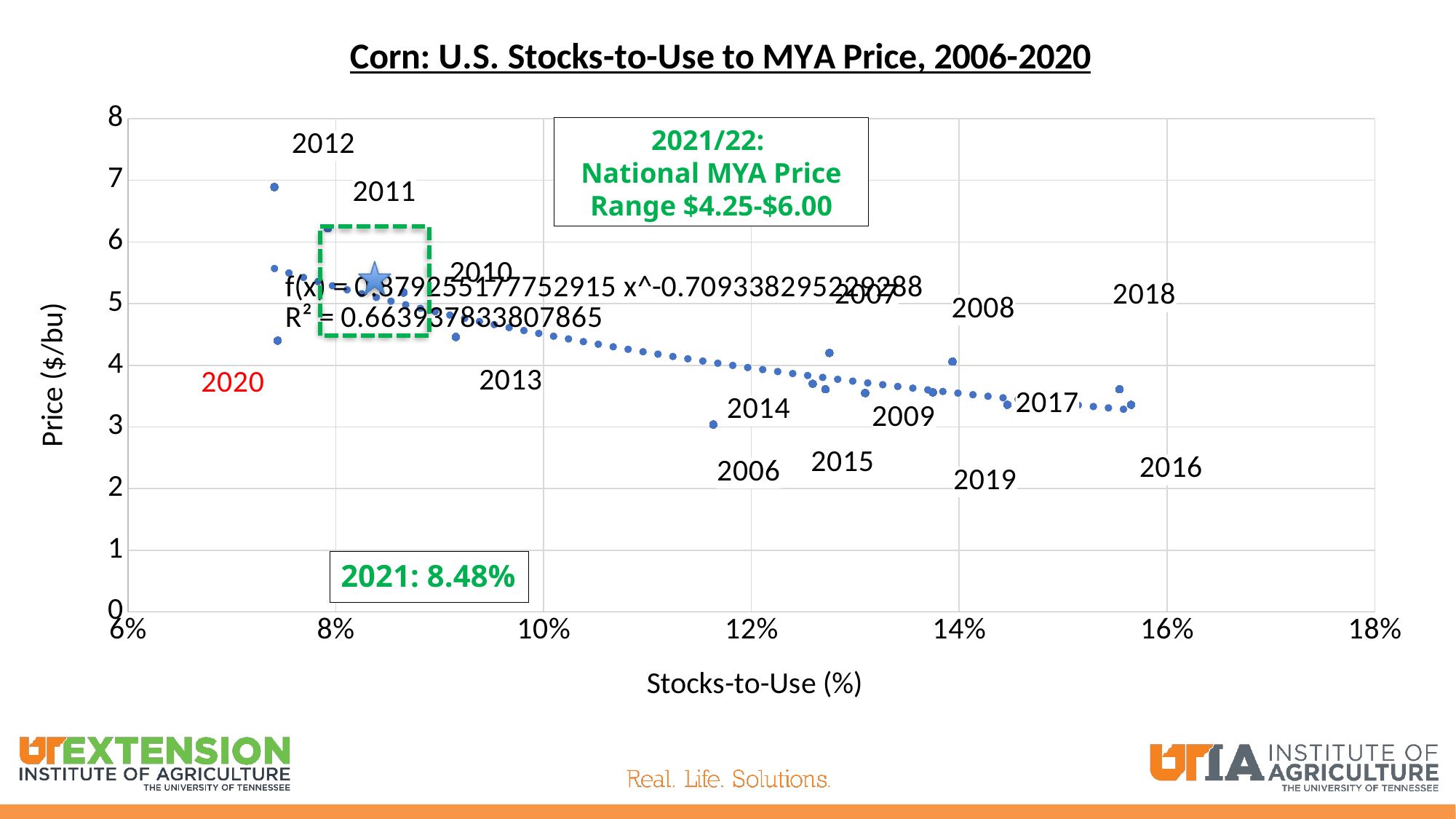
What is the label of the vertical axis? Price ($/bu) Is the price for 2020 greater or less than 4 $/bu? greater What stocks-to-use percentage is given for 2021 in the text box on the chart? 8.48% How many years (data points) are plotted on the chart? 15 Which year has the lowest MYA price on the chart? 2006 Which year has the higher price, 2008 or 2009? 2008 Is the price for 2012 greater or less than 6 $/bu? greater What kind of chart is shown on the slide? Scatter chart Is the price for 2014 greater or less than 4 $/bu? less What is the title of the chart? Corn: U.S. Stocks-to-Use to MYA Price, 2006-2020 As stocks-to-use increases along the x axis, does the trendline price rise or fall? Fall Which year has the highest MYA price on the chart? 2012